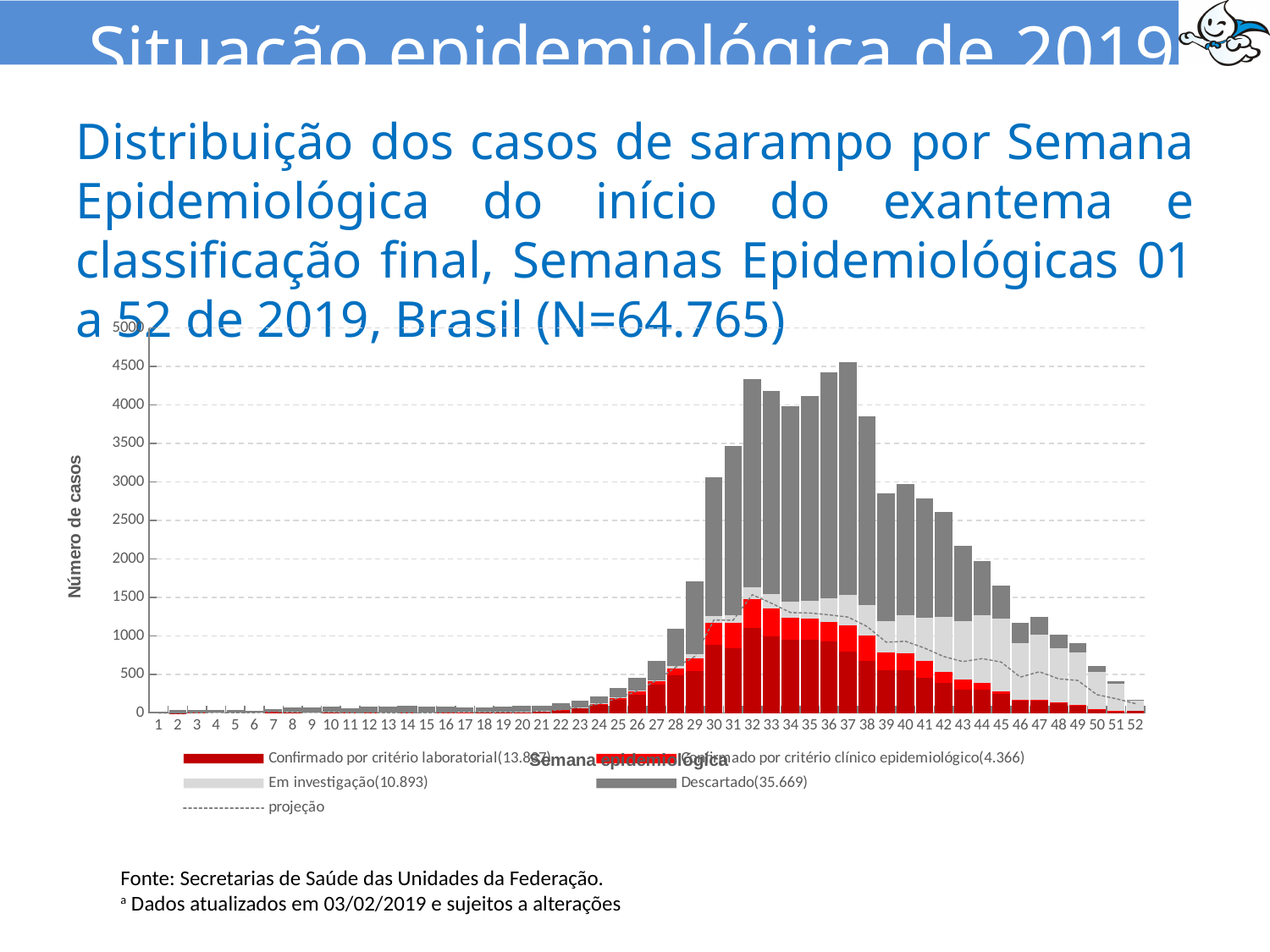
Is the total bar for week 25 greater or less than 500? less What is the title of the y axis? Número de casos Is the total bar for week 29 greater or less than 2000? less How many entries does the legend list? 5 What kind of chart is shown on the slide? stacked bar chart with a dashed line (projection) Is the total bar for week 37 greater or less than 4000? greater What number is shown in parentheses in the legend for 'Descartado'? 35.669 Do the total bars rise or fall from week 37 to week 52? fall Which epidemiological week has the tallest total bar? 37 How many epidemiological weeks are shown along the x axis? 52 Which total bar is taller, week 37 or week 38? week 37